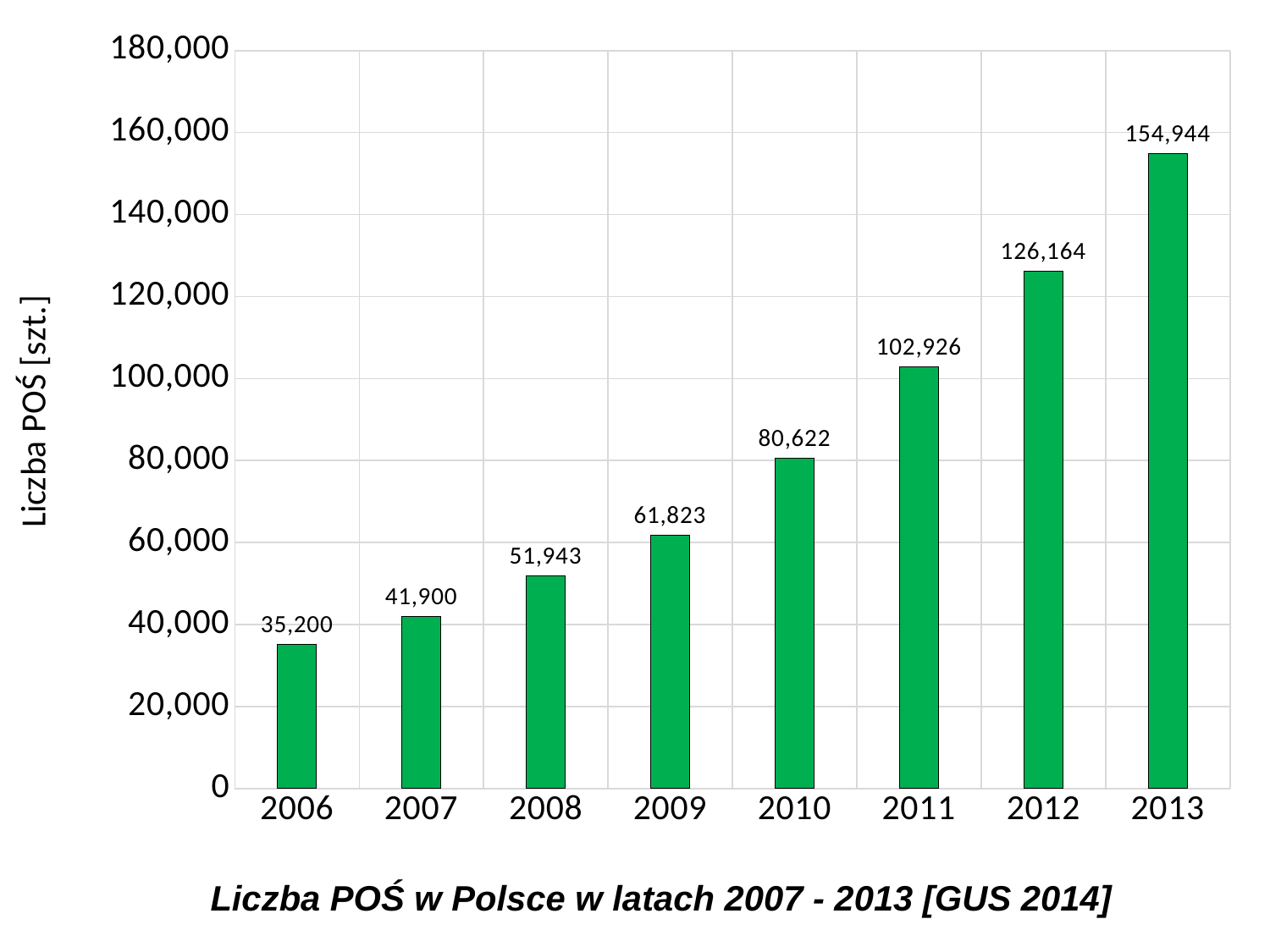
Is the value for 2012 greater or less than 120,000? greater What is the difference between the values for 2013 and 2012? 28,780 What is the value for 2006? 35,200 What is the value for 2010? 80,622 What is the difference between the values for 2007 and 2006? 6,700 What is the value for 2013? 154,944 Which year has the lowest value? 2006 How many years are shown on the x axis? 8 Which year has the highest value? 2013 Do the values rise or fall from 2006 to 2013? rise What kind of chart is this? bar chart Which is larger, the value for 2009 or the value for 2011? 2011